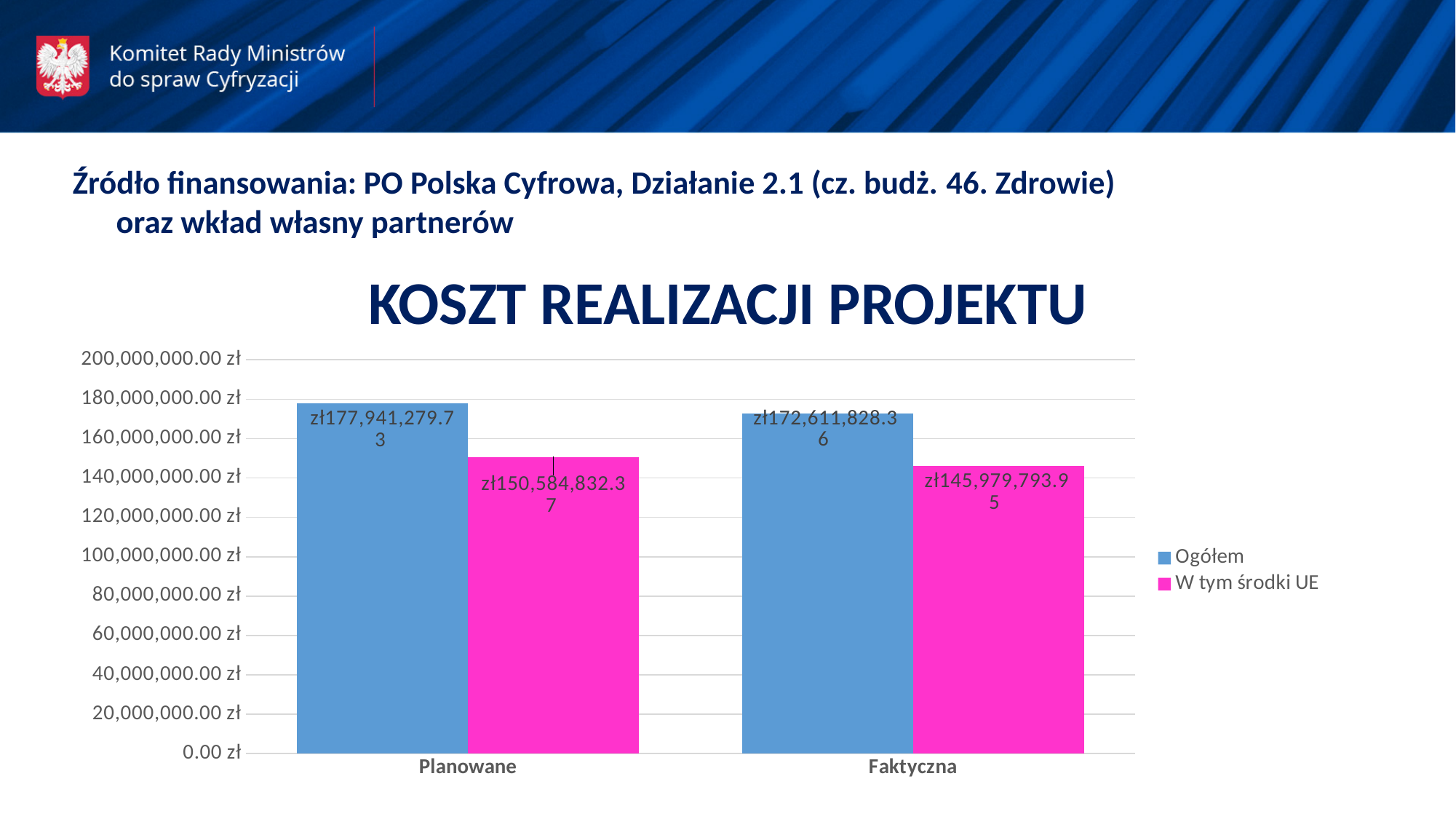
What is the W tym środki UE value for Faktyczna? zł145,979,793.95 What is the Ogółem value for Planowane? zł177,941,279.73 Which category has the higher Ogółem value, Planowane or Faktyczna? Planowane How many categories are shown on the x axis? 2 What is the Ogółem value for Faktyczna? zł172,611,828.36 Which series is shown in pink in the legend? W tym środki UE What type of chart is shown on the slide? bar chart What is the title of the chart? KOSZT REALIZACJI PROJEKTU How many series does the legend list? 2 What is the difference between the Ogółem and W tym środki UE values for Faktyczna? zł26,632,034.41 What is the W tym środki UE value for Planowane? zł150,584,832.37 What is the difference between the Ogółem values for Planowane and Faktyczna? zł5,329,451.37